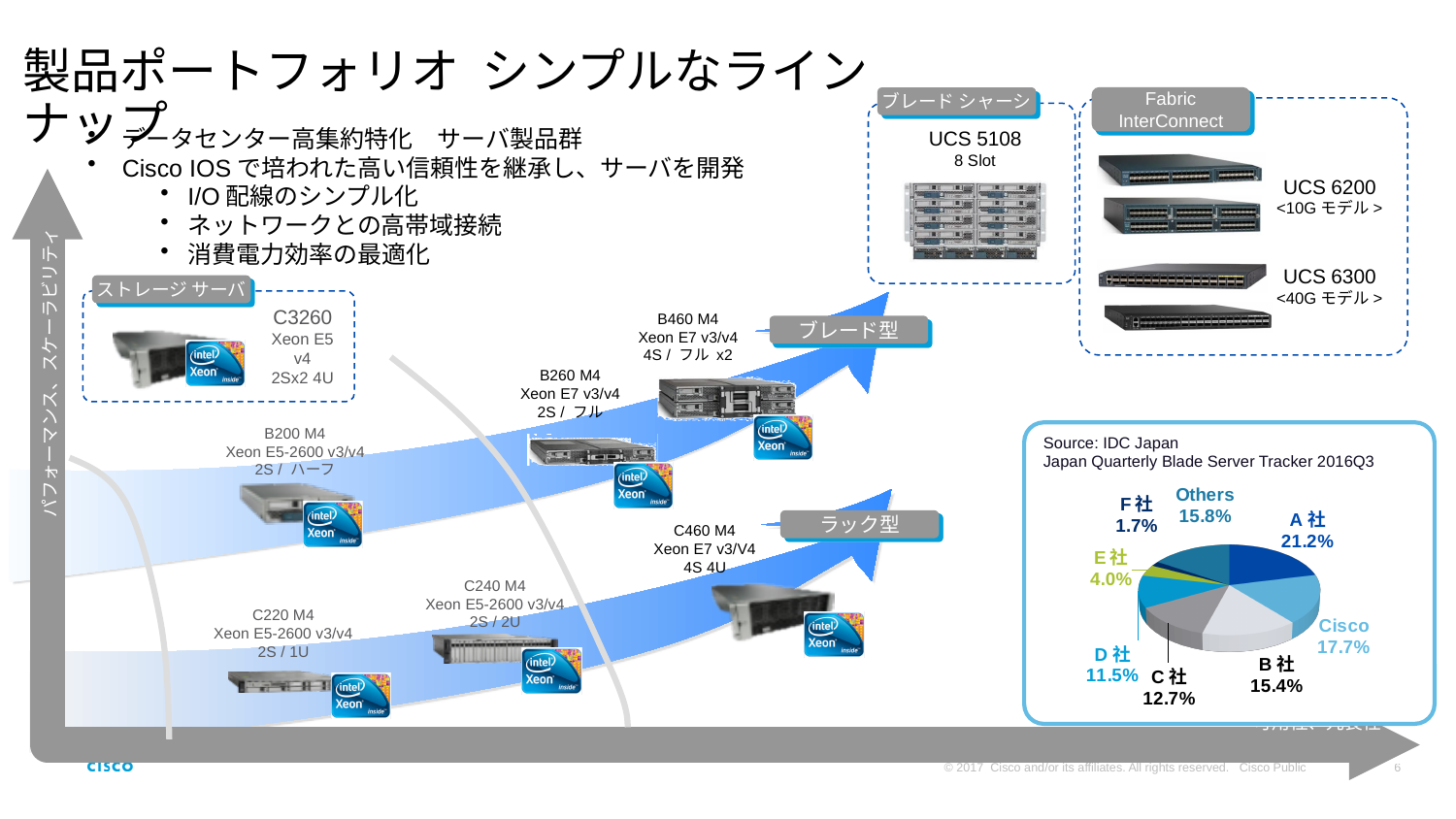
Which slice of the pie chart is the smallest? F社 In the pie chart, what is the difference between the share of A社 and the share of Cisco? 3.5% In the pie chart, what share does A社 hold? 21.2% In the pie chart, what is the difference between the share of D社 and the share of E社? 7.5% What kind of chart is shown in the box sourced from IDC Japan? pie chart Which slice of the pie chart is the largest? A社 In the pie chart, what share is labelled for Others? 15.8% In the pie chart, what share does Cisco hold? 17.7% In the pie chart, what share does E社 hold? 4.0% How many slices does the pie chart have? 8 In the pie chart, which is larger, the share of B社 or the share of C社? B社 What source is cited for the pie chart data? IDC Japan, Japan Quarterly Blade Server Tracker 2016Q3